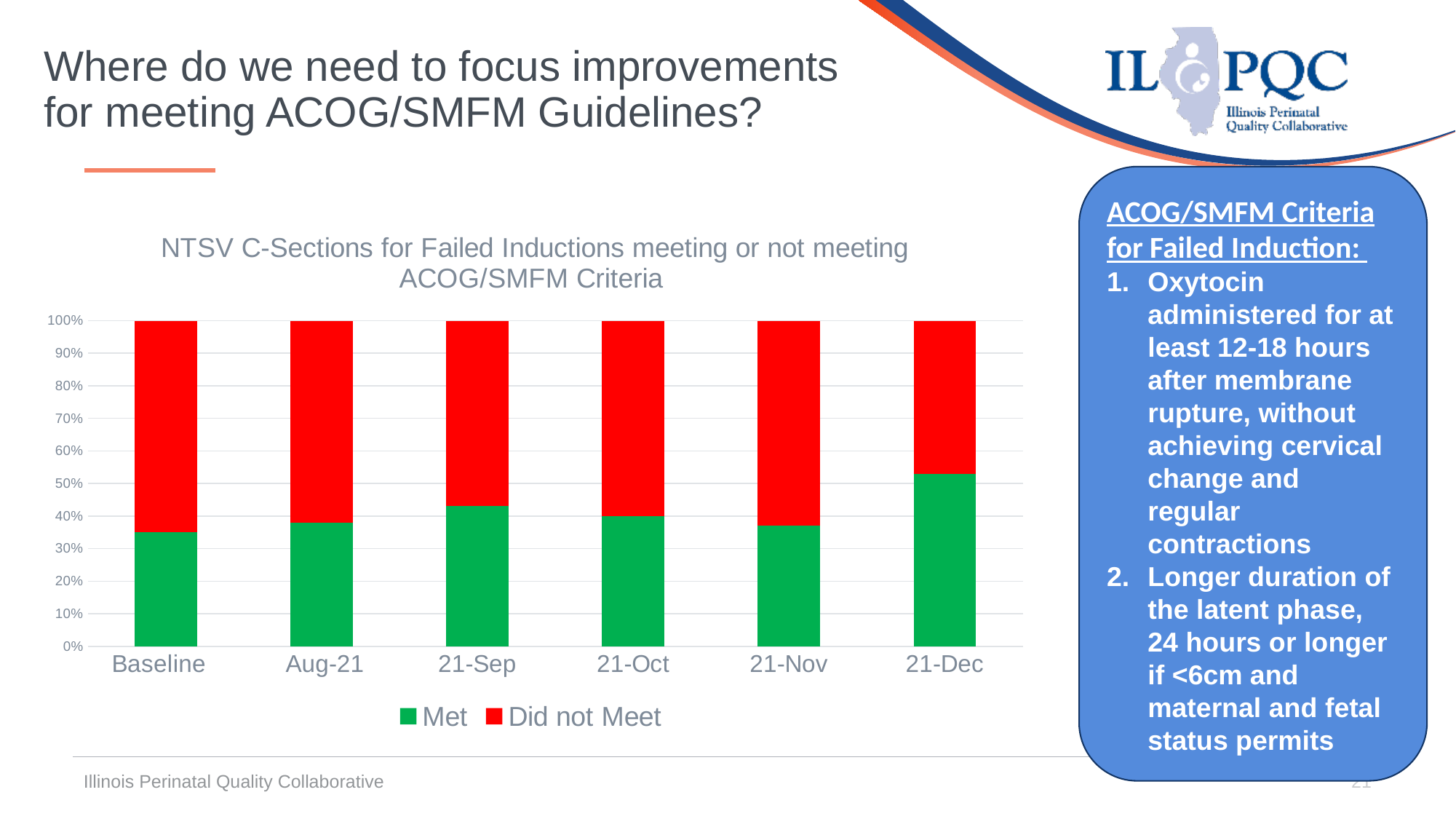
What are the two series named in the chart legend? Met and Did not Meet Which category has the highest share of 'Met'? 21-Dec What is the title of the chart? NTSV C-Sections for Failed Inductions meeting or not meeting ACOG/SMFM Criteria Is the 'Met' value for 21-Sep greater or less than 40%? greater How many series does the chart legend list? 2 Is the 'Met' value for 21-Dec greater or less than 50%? greater Which has a larger 'Met' share, Baseline or 21-Dec? 21-Dec How many categories are shown on the x axis of the chart? 6 Is the 'Did not Meet' value for Baseline greater or less than 60%? greater What type of chart is shown on the slide? Stacked bar chart What is the total of the stacked bar for Baseline? 100%